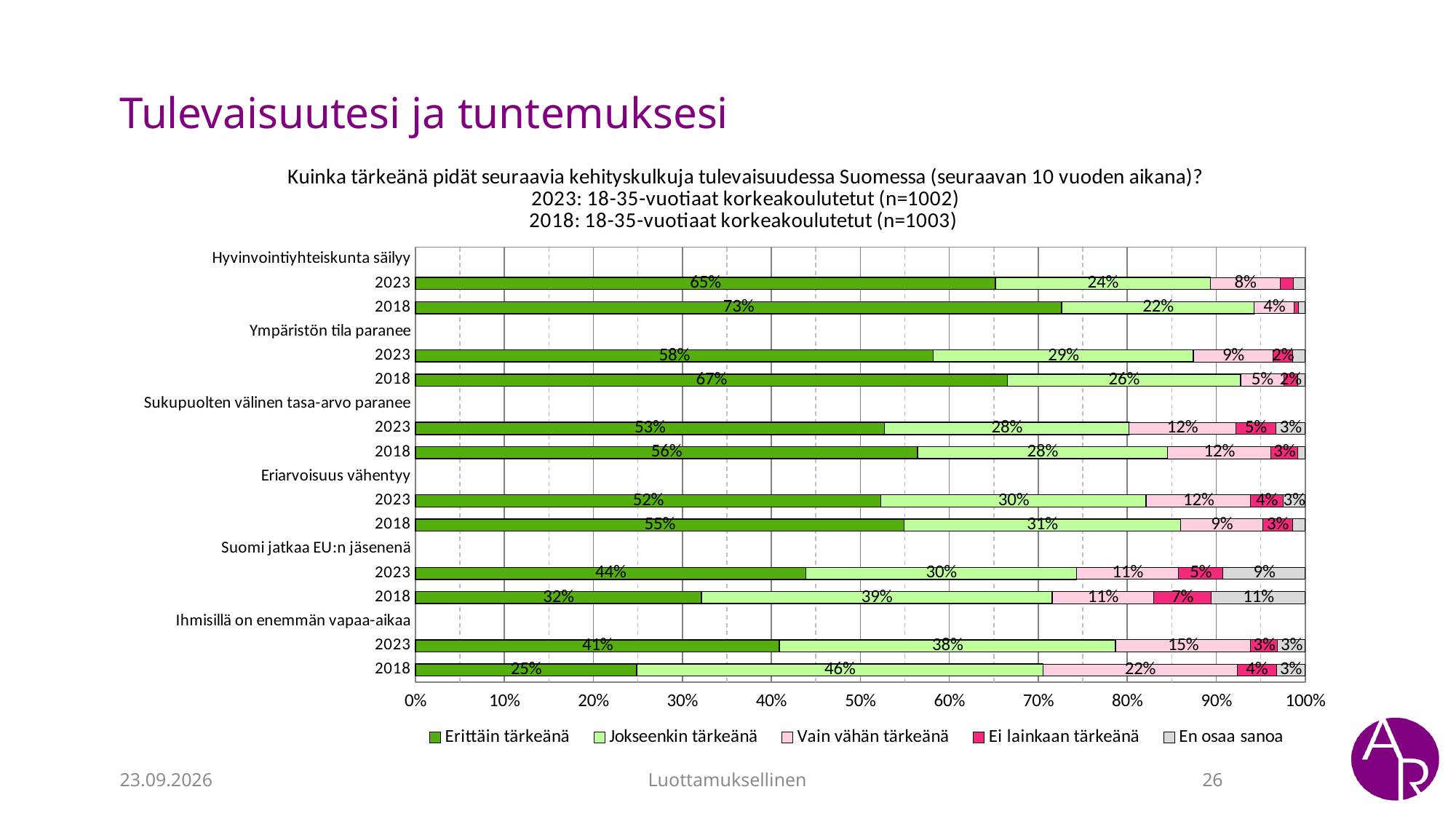
What is the 'Vain vähän tärkeänä' value for 'Ihmisillä on enemmän vapaa-aikaa' in 2023? 15% How many topics (statements) are compared in the chart? 6 Which legend entry is shown in dark green? Erittäin tärkeänä What share of respondents in 2023 considered 'Hyvinvointiyhteiskunta säilyy' Erittäin tärkeänä? 65% By how many percentage points did the 'Erittäin tärkeänä' share for 'Suomi jatkaa EU:n jäsenenä' change from 2018 to 2023? 12 percentage points (32% to 44%) How many series does the legend list? 5 Which bar has the highest 'Erittäin tärkeänä' share? Hyvinvointiyhteiskunta säilyy, 2018 (73%) What is the 'Jokseenkin tärkeänä' value for 'Ihmisillä on enemmän vapaa-aikaa' in 2018? 46% What is the 'En osaa sanoa' value for 'Suomi jatkaa EU:n jäsenenä' in 2018? 11% Which bar has the lowest 'Erittäin tärkeänä' share? Ihmisillä on enemmän vapaa-aikaa, 2018 (25%) For 'Ympäristön tila paranee', was the 'Erittäin tärkeänä' share larger in 2023 or in 2018? 2018 What type of chart is shown on the slide? Stacked bar chart